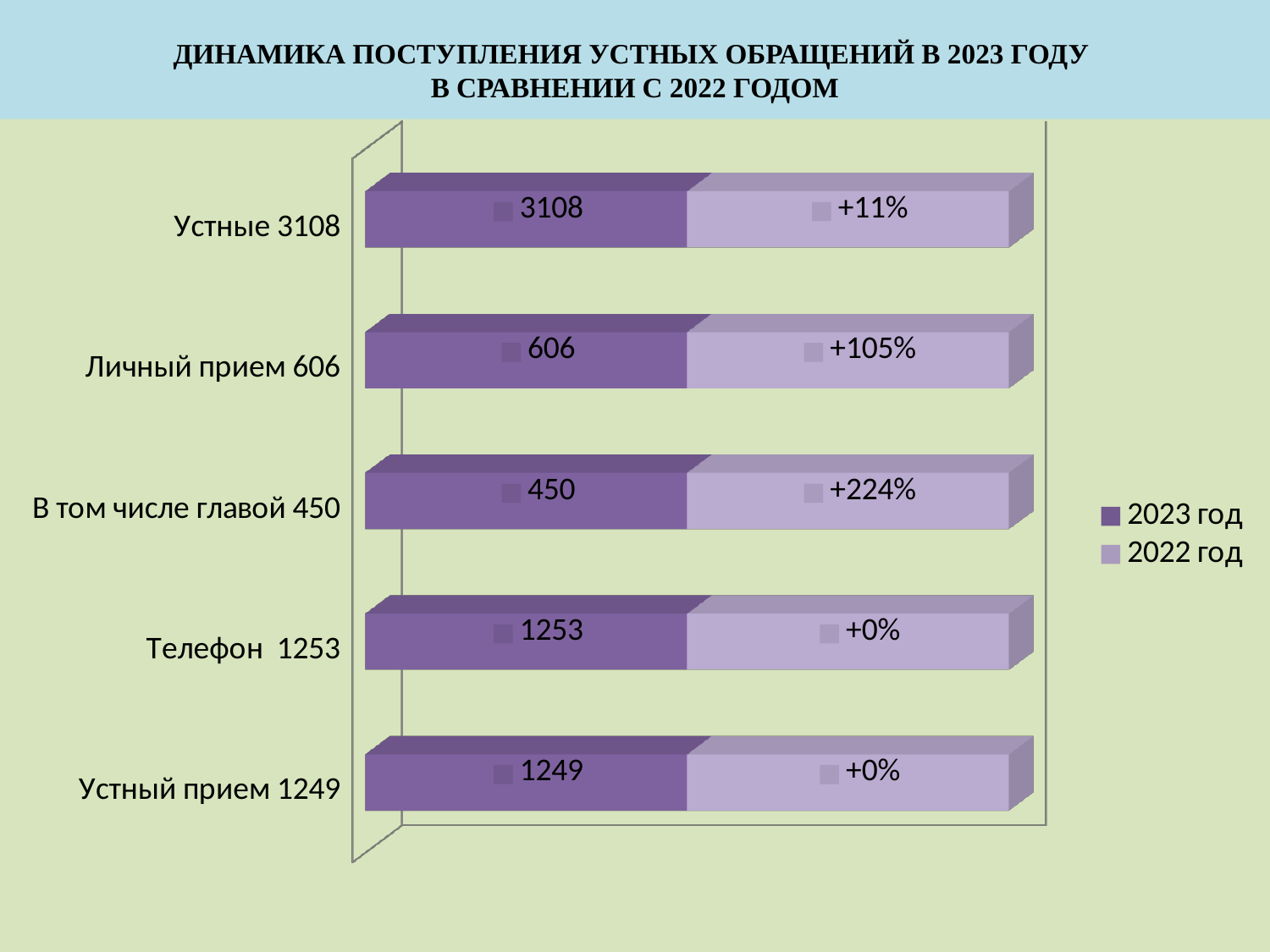
What label is shown on the 2022 год segment for 'В том числе главой'? +224% What label is shown on the 2022 год segment for 'Личный прием'? +105% What is the 2023 год value labelled for the category 'Устные'? 3108 How many categories are plotted in the chart? 5 Which series is shown in the darker purple colour? 2023 год What is the difference between the 2023 год values for 'Телефон' and 'Устный прием'? 4 What is the 2023 год value labelled for 'В том числе главой'? 450 Which category has the highest labelled 2023 год value? Устные Which category has the lowest labelled 2023 год value? В том числе главой How many series does the legend list? 2 What kind of chart is shown on the slide? bar chart What is the 2023 год value labelled for 'Личный прием'? 606